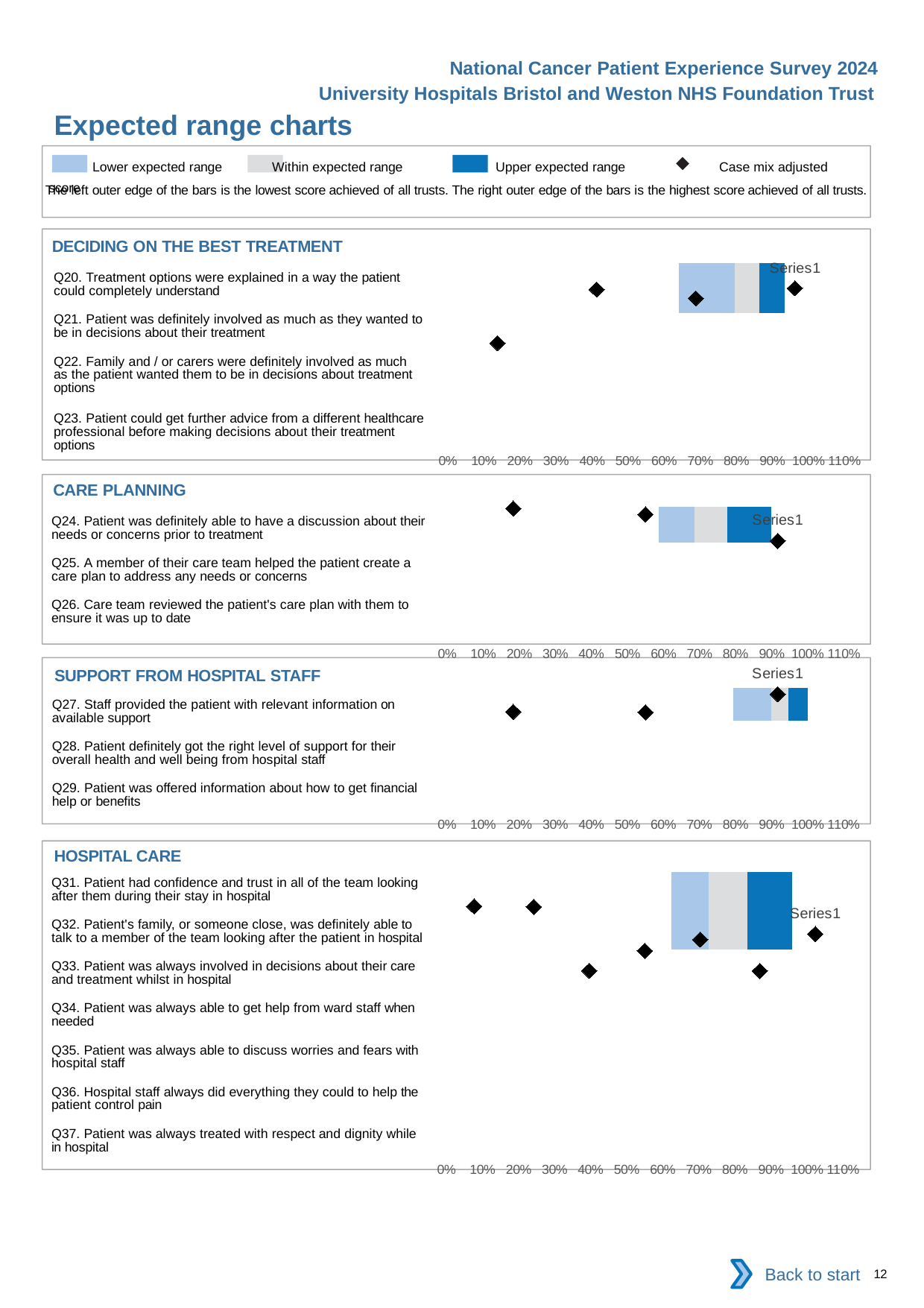
How many question rows are listed in the 'HOSPITAL CARE' chart? 7 What is the highest tick label shown on the x axis of the 'HOSPITAL CARE' chart? 110% How many question rows are listed in the 'SUPPORT FROM HOSPITAL STAFF' chart? 3 How many question rows are listed in the 'CARE PLANNING' chart? 3 In the 'CARE PLANNING' chart, is the leftmost diamond marker greater or less than 30%? less Which legend entry is represented by a black diamond marker? Case mix adjusted score In the 'DECIDING ON THE BEST TREATMENT' chart, is the leftmost diamond marker greater or less than 20%? less What kind of chart is used in the 'DECIDING ON THE BEST TREATMENT' section? bar chart How many entries does the legend at the top of the slide list? 4 In the 'HOSPITAL CARE' chart, is the rightmost diamond marker greater or less than 80%? greater